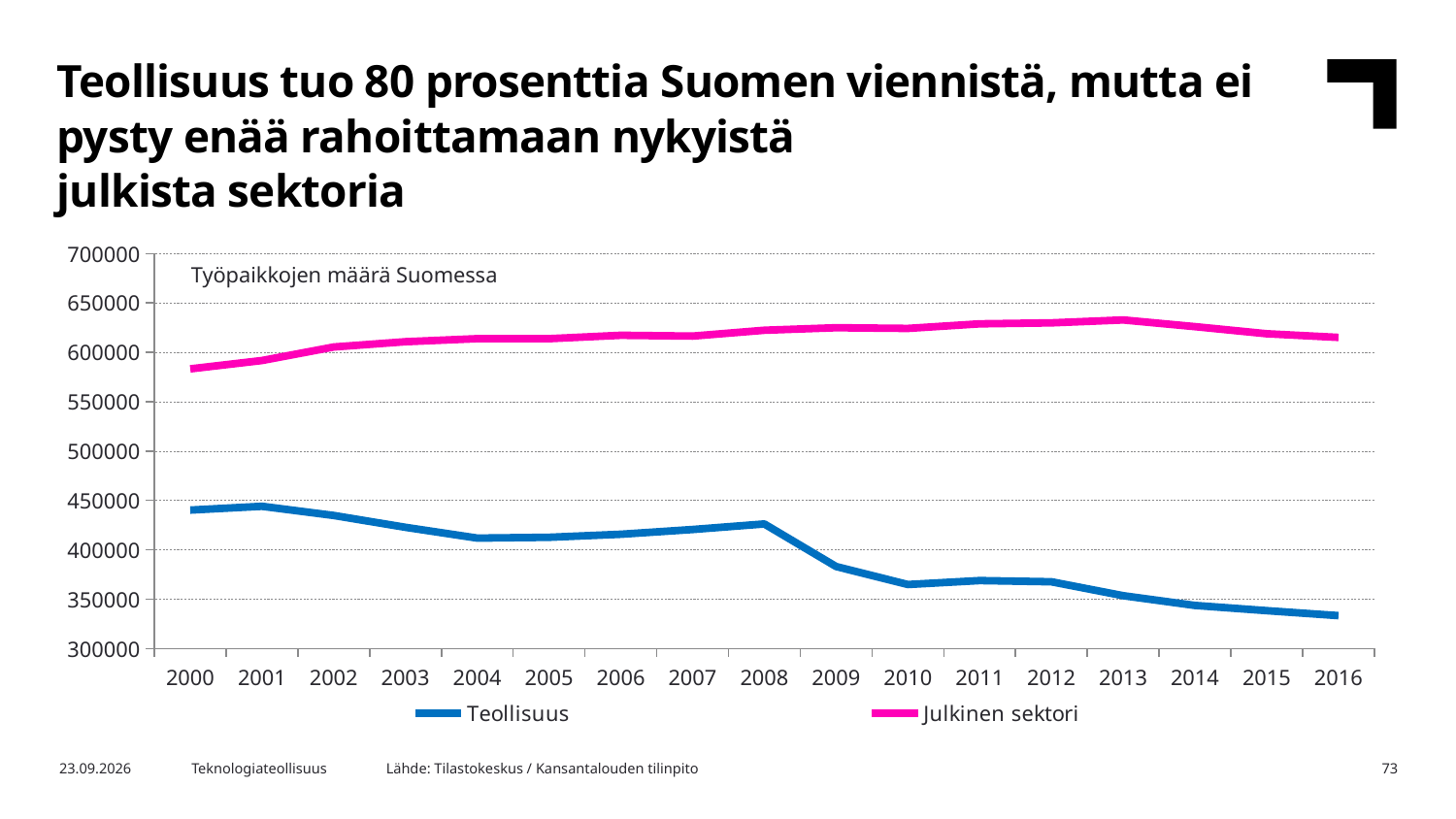
Which series is drawn in pink? Julkinen sektori How many years are plotted along the x axis? 17 In which year is the Teollisuus value lowest? 2016 In 2016, which series has the larger value, Teollisuus or Julkinen sektori? Julkinen sektori Does the Julkinen sektori line rise or fall overall from 2000 to 2016? rise Does the Teollisuus line rise or fall overall from 2000 to 2016? fall How many series does the legend list? 2 In which year is the Julkinen sektori value lowest? 2000 What kind of chart is shown on the slide? line chart Is the Teollisuus value for 2016 greater or less than 350000? less Is the Julkinen sektori value for 2013 greater or less than 600000? greater What is the title printed inside the chart area? Työpaikkojen määrä Suomessa